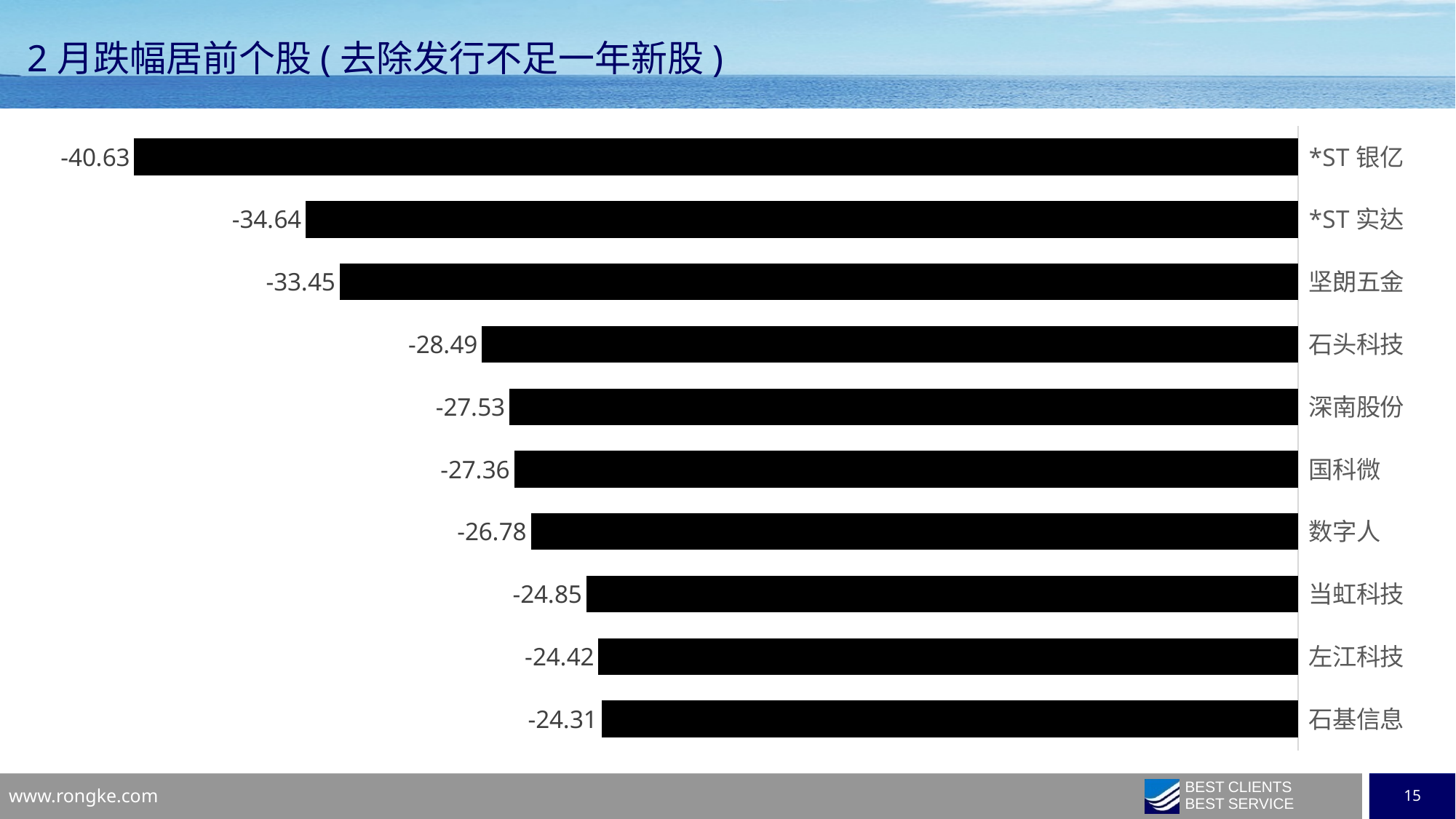
What is the title of the slide? 2 月跌幅居前个股 ( 去除发行不足一年新股 ) Which stock has the largest decline (the lowest value) on the chart? *ST 银亿 Which stock has the smallest decline (the highest value) on the chart? 石基信息 What is the difference between the values for *ST 银亿 and *ST 实达? 5.99 What is the difference between the values for 坚朗五金 and 石头科技? 4.96 What is the value shown for *ST 银亿? -40.63 What is the value shown for 数字人? -26.78 Which has the larger decline, 深南股份 or 当虹科技? 深南股份 How many stocks are shown on the chart? 10 What is the value shown for 石头科技? -28.49 What is the value shown for 石基信息? -24.31 What kind of chart is shown on the slide? Bar chart